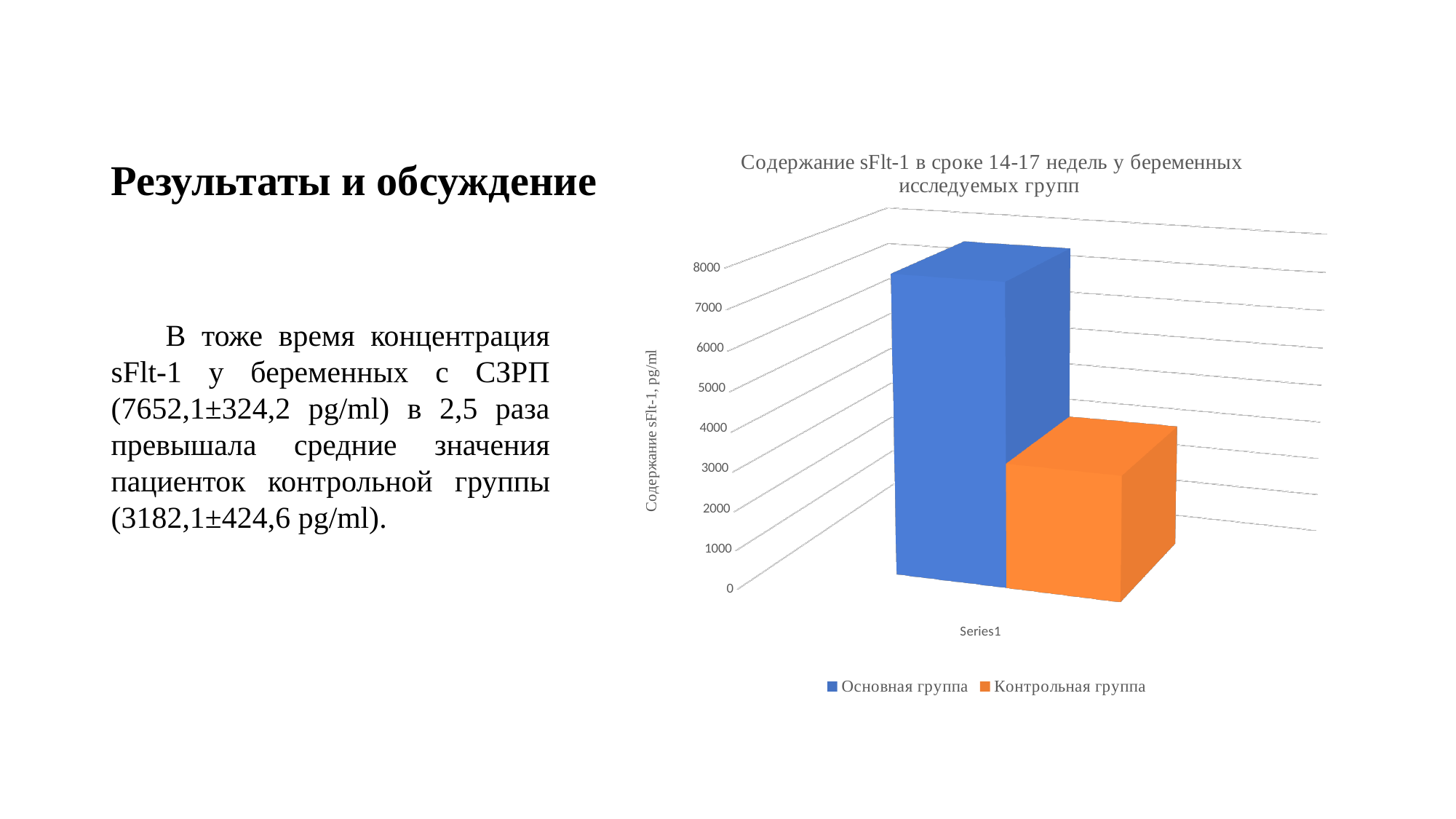
Is the value for Основная группа greater or less than 7000? greater How many series does the chart legend list? 2 What is the label of the vertical axis of the chart? Содержание sFlt-1, pg/ml Which series has the shortest bar in the chart? Контрольная группа How many categories are shown on the x axis of the chart? 1 Is the value for Контрольная группа greater or less than 2000? greater What kind of chart is shown on the slide? bar chart Is the value for Основная группа greater or less than 8000? less Which group has the higher sFlt-1 value in the chart, Основная группа or Контрольная группа? Основная группа What is the title of the chart? Содержание sFlt-1 в сроке 14-17 недель у беременных исследуемых групп Which series has the tallest bar in the chart? Основная группа